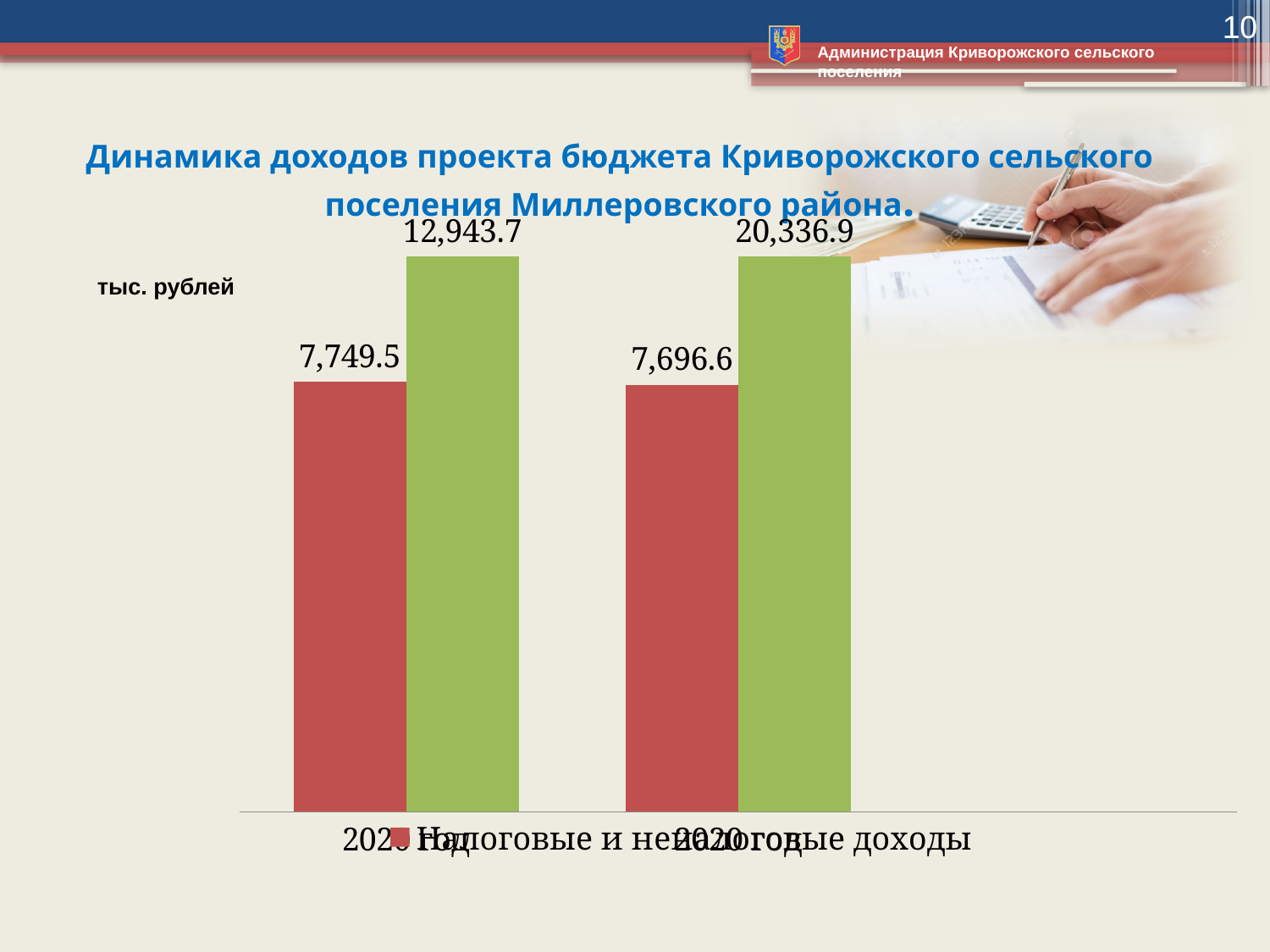
What is the highest value shown on the chart? 20,336.9 What is the value of the red bar in the left group of bars? 7,749.5 What is the difference between the green bar and the red bar in the right group of bars? 12,640.3 What is the value of the red bar in the right group of bars? 7,696.6 What unit of measurement is indicated on the chart? тыс. рублей What is the lowest value shown on the chart? 7,696.6 What kind of chart is shown on the slide? bar chart Which green bar is larger, the one in the left group or the one in the right group? the right group What is the difference between the green bar in the right group and the green bar in the left group? 7,393.2 What is the value of the green bar in the left group of bars? 12,943.7 What is the value of the green bar in the right group of bars? 20,336.9 How many groups of bars are shown on the chart? 2